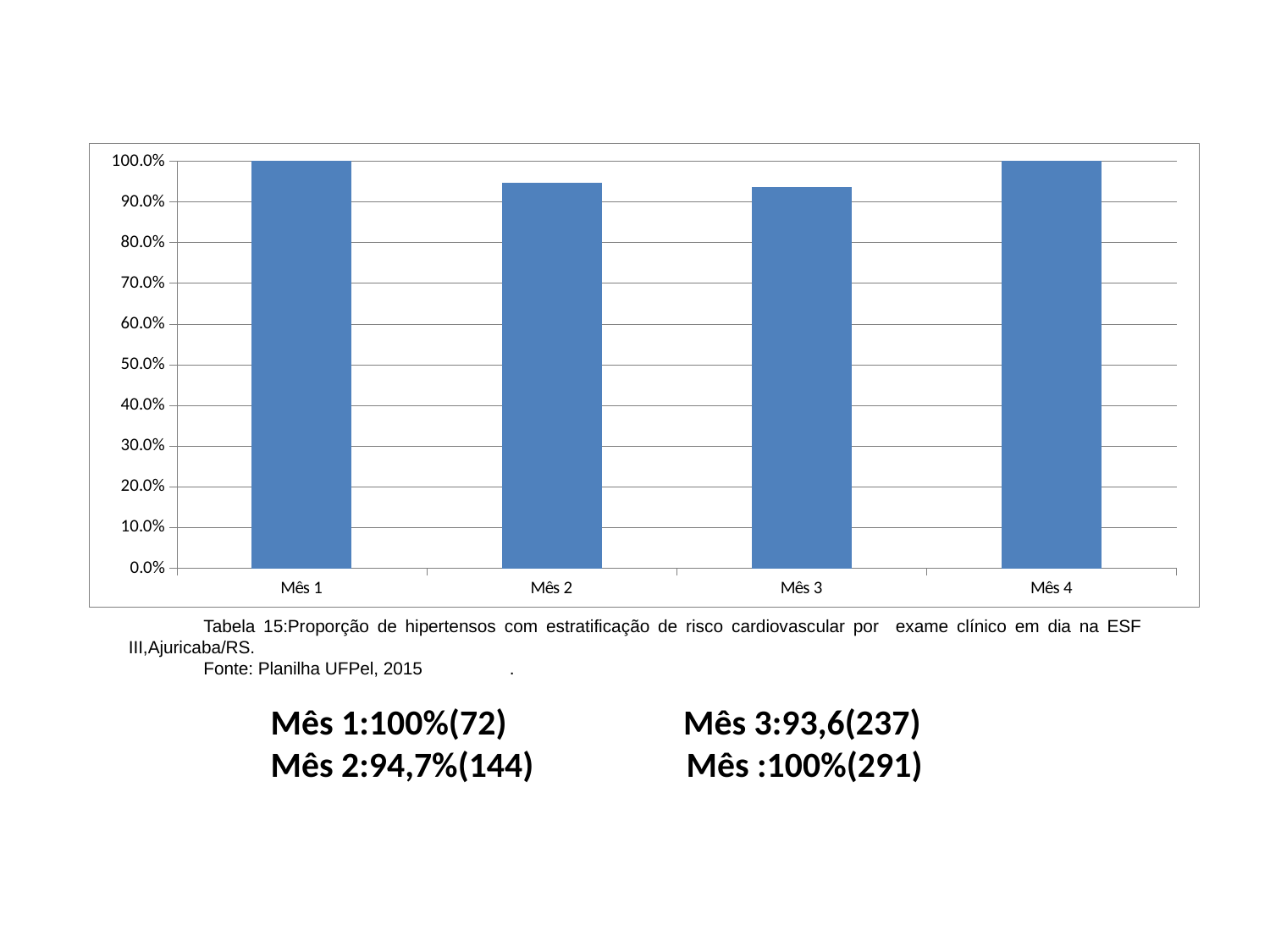
What is the value for Mês 1? 100.0% What is the source cited below the chart? Planilha UFPel, 2015 According to the text below the chart, what number in parentheses is given for Mês 3? 237 According to the text below the chart, what percentage is given for Mês 2? 94,7% Which is larger, the value for Mês 3 or the value for Mês 4? Mês 4 What kind of chart is shown on the slide? bar chart How many categories (months) are plotted on the x axis? 4 What colour are the bars in the chart? blue Which is larger, the value for Mês 1 or the value for Mês 2? Mês 1 Is the value for Mês 3 greater or less than 90%? greater What is the value for Mês 4? 100.0% Is the value for Mês 2 greater or less than 90%? greater